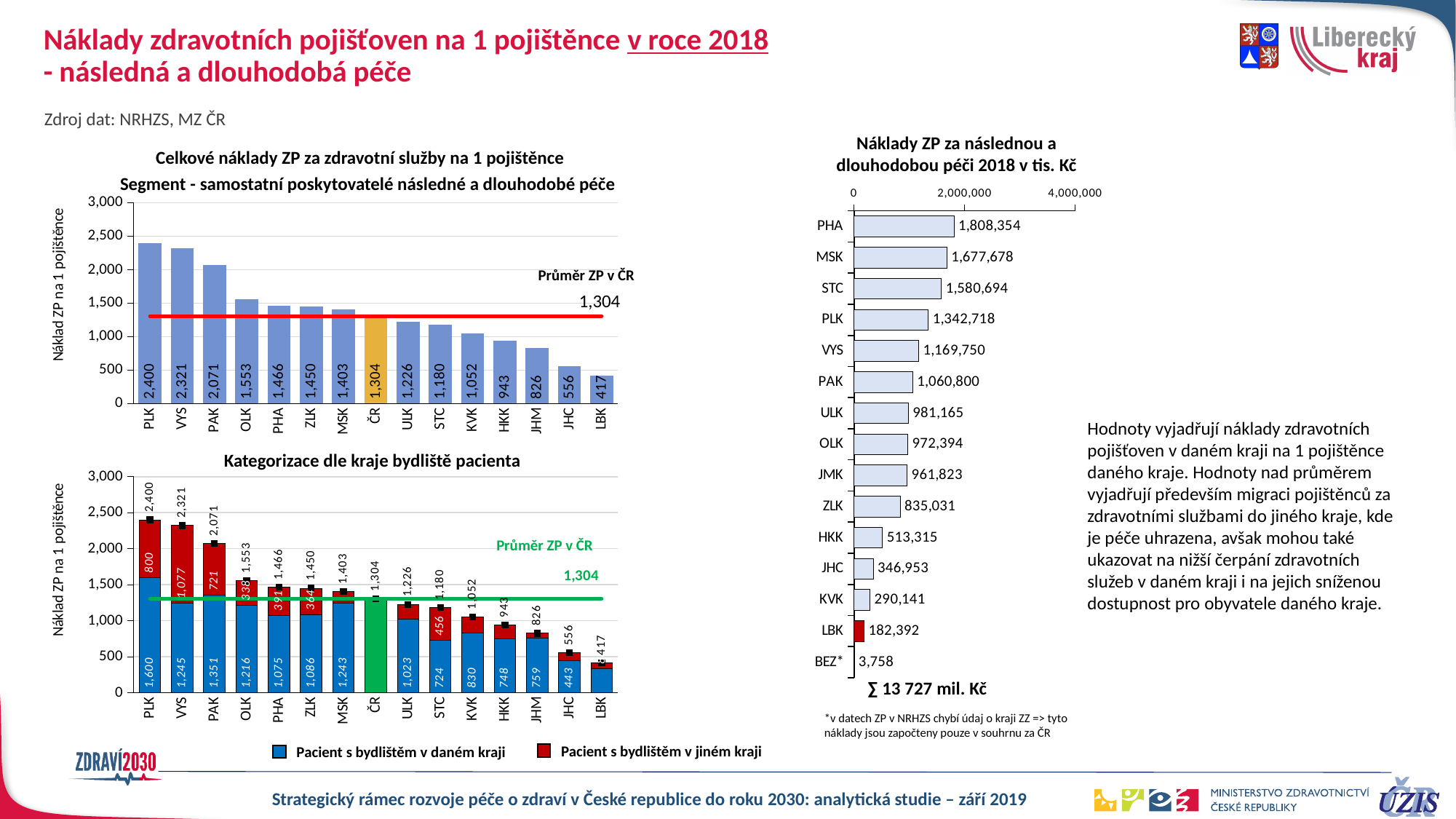
In the top-left chart 'Celkové náklady ZP za zdravotní služby na 1 pojištěnce', what is the value shown for the ČR average (Průměr ZP v ČR)? 1,304 In the top-left chart 'Celkové náklady ZP za zdravotní služby na 1 pojištěnce', how many bars are plotted? 15 In the top-left chart 'Celkové náklady ZP za zdravotní služby na 1 pojištěnce', which region has the lowest value? LBK In the top-left chart 'Celkové náklady ZP za zdravotní služby na 1 pojištěnce', what is the difference between the values for PLK and LBK? 1,983 What kind of chart is the right chart 'Náklady ZP za následnou a dlouhodobou péči 2018 v tis. Kč'? Bar chart In the right chart 'Náklady ZP za následnou a dlouhodobou péči 2018 v tis. Kč', what is the value for LBK? 182,392 In the bottom-left chart 'Kategorizace dle kraje bydliště pacienta', what is the value for 'Pacient s bydlištěm v jiném kraji' for STC? 456 In the bottom-left chart 'Kategorizace dle kraje bydliště pacienta', how many series does the legend list? 2 In the bottom-left chart 'Kategorizace dle kraje bydliště pacienta', what is the value for 'Pacient s bydlištěm v daném kraji' for PLK? 1,600 In the bottom-left chart 'Kategorizace dle kraje bydliště pacienta', what is the total of the stacked bar for VYS? 2,321 In the top-left chart 'Celkové náklady ZP za zdravotní služby na 1 pojištěnce', what is the value for PLK? 2,400 In the right chart 'Náklady ZP za následnou a dlouhodobou péči 2018 v tis. Kč', which region has the highest value? PHA